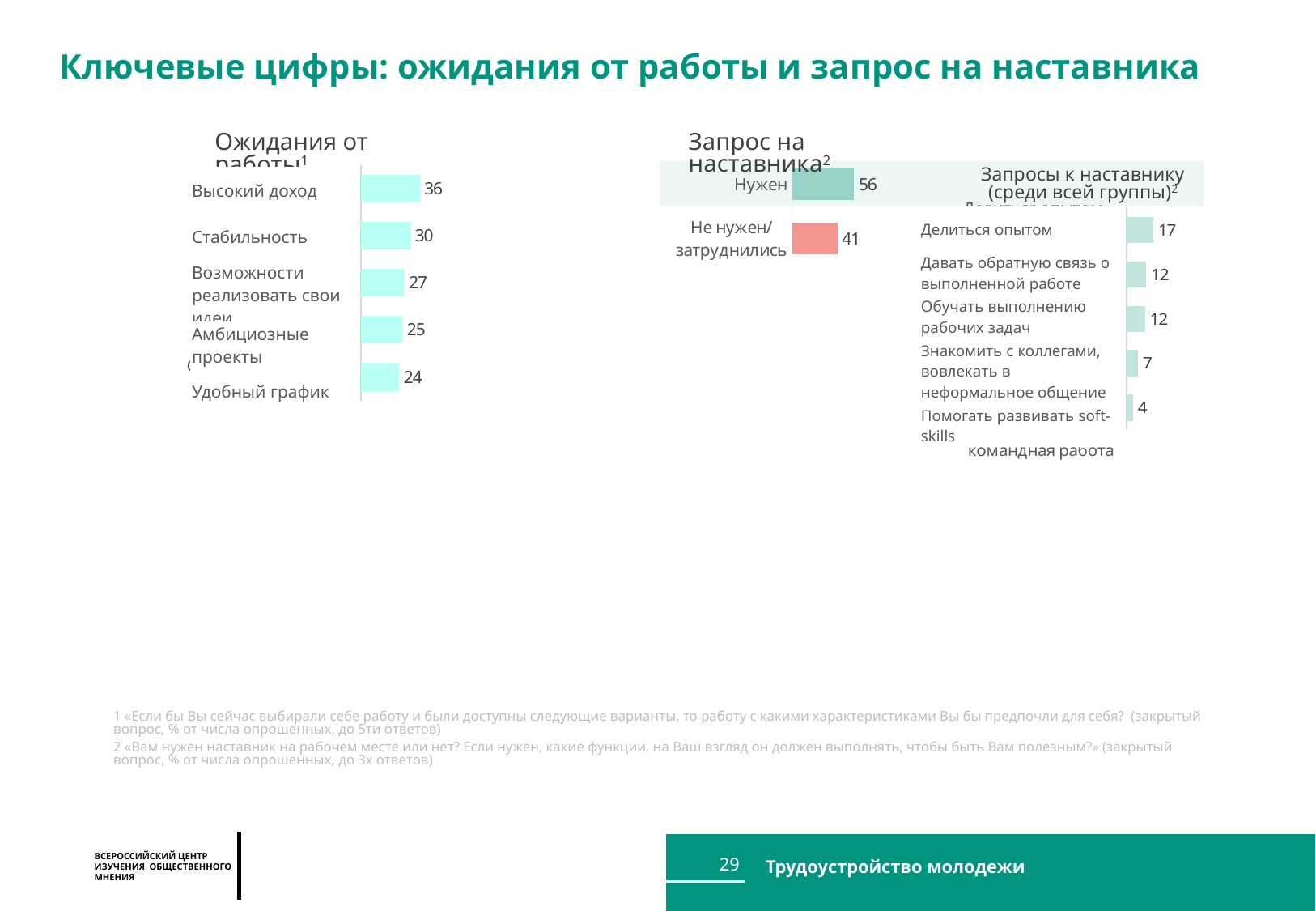
In the chart 'Запрос на наставника', what is the difference between 'Нужен' and 'Не нужен/затруднились'? 15 In the chart 'Запросы к наставнику (среди всей группы)', which category has the lowest value? Помогать развивать soft-skills In the chart 'Запросы к наставнику (среди всей группы)', how many categories are shown? 5 What type of chart is 'Ожидания от работы'? Bar chart In the chart 'Запрос на наставника', which is larger: 'Нужен' or 'Не нужен/затруднились'? Нужен In the chart 'Запрос на наставника', what is the value for 'Нужен'? 56 In the chart 'Ожидания от работы', how many categories are shown? 5 In the chart 'Запросы к наставнику (среди всей группы)', what is the value for 'Делиться опытом'? 17 In the chart 'Ожидания от работы', which category has the lowest value? Удобный график In the chart 'Запросы к наставнику (среди всей группы)', what is the value for 'Обучать выполнению рабочих задач'? 12 In the chart 'Ожидания от работы', what is the difference between 'Стабильность' and 'Удобный график'? 6 In the chart 'Ожидания от работы', what is the value for 'Высокий доход'? 36